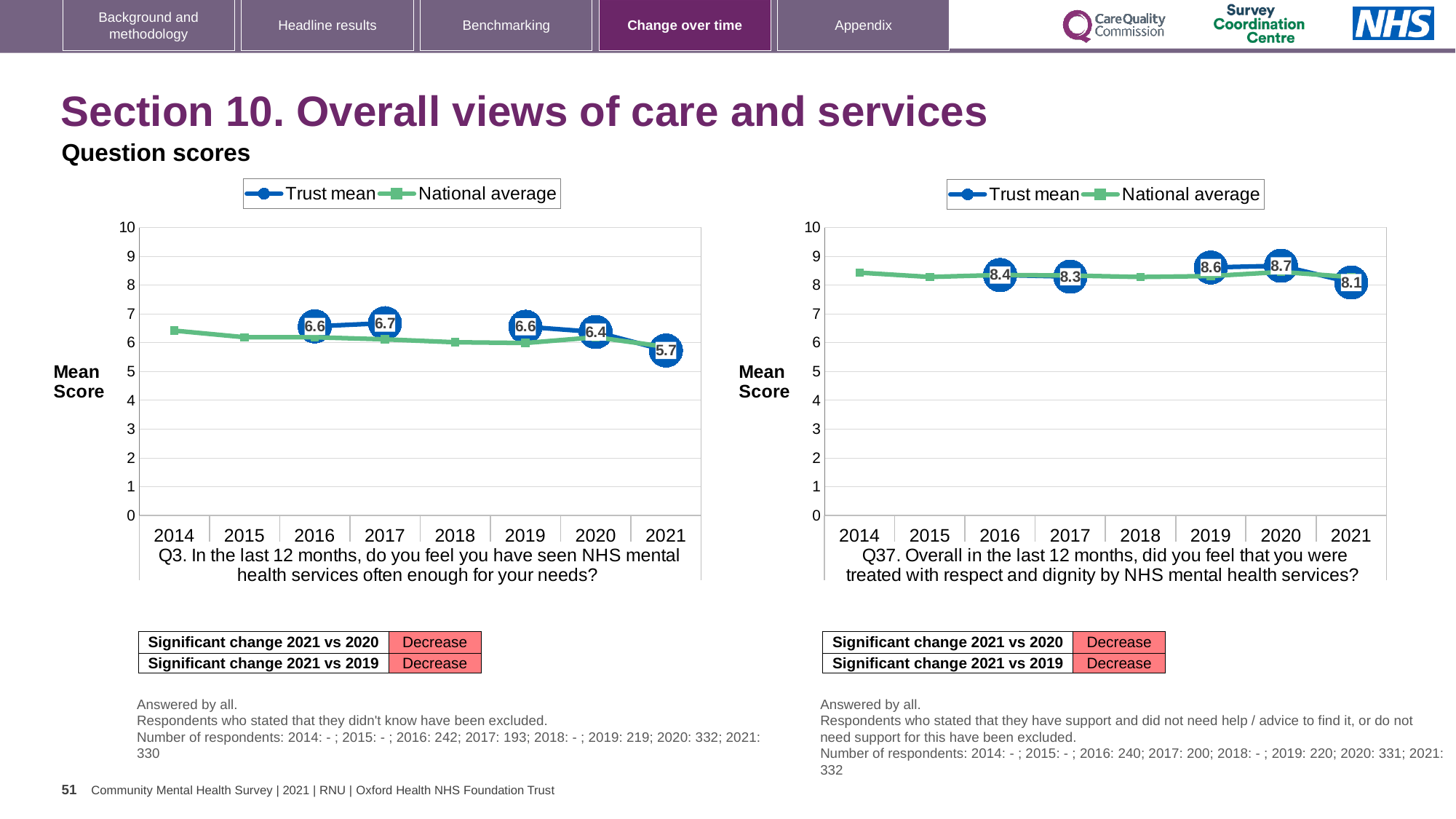
In the Q37 chart on the right, what is the difference between the Trust mean in 2019 and in 2021? 0.5 How many series does the legend of the Q3 chart on the left list? 2 What type of chart is the Q37 chart on the right? Line chart In the Q3 chart on the left, is the National average for 2014 greater or less than 7? less In the Q37 chart on the right, what is the Trust mean for 2020? 8.7 In the Q37 chart on the right, is the Trust mean higher in 2016 or in 2017? 2016 In the Q37 chart on the right, which year has the highest labelled Trust mean? 2020 In the Q3 chart on the left, what is the difference between the Trust mean in 2020 and in 2021? 0.7 In the Q3 chart on the left, what is the Trust mean for 2021? 5.7 In the Q3 chart on the left, what is the Trust mean for 2017? 6.7 In the Q37 chart on the right, what is the Trust mean for 2021? 8.1 In the Q3 chart on the left, which year has the lowest labelled Trust mean? 2021